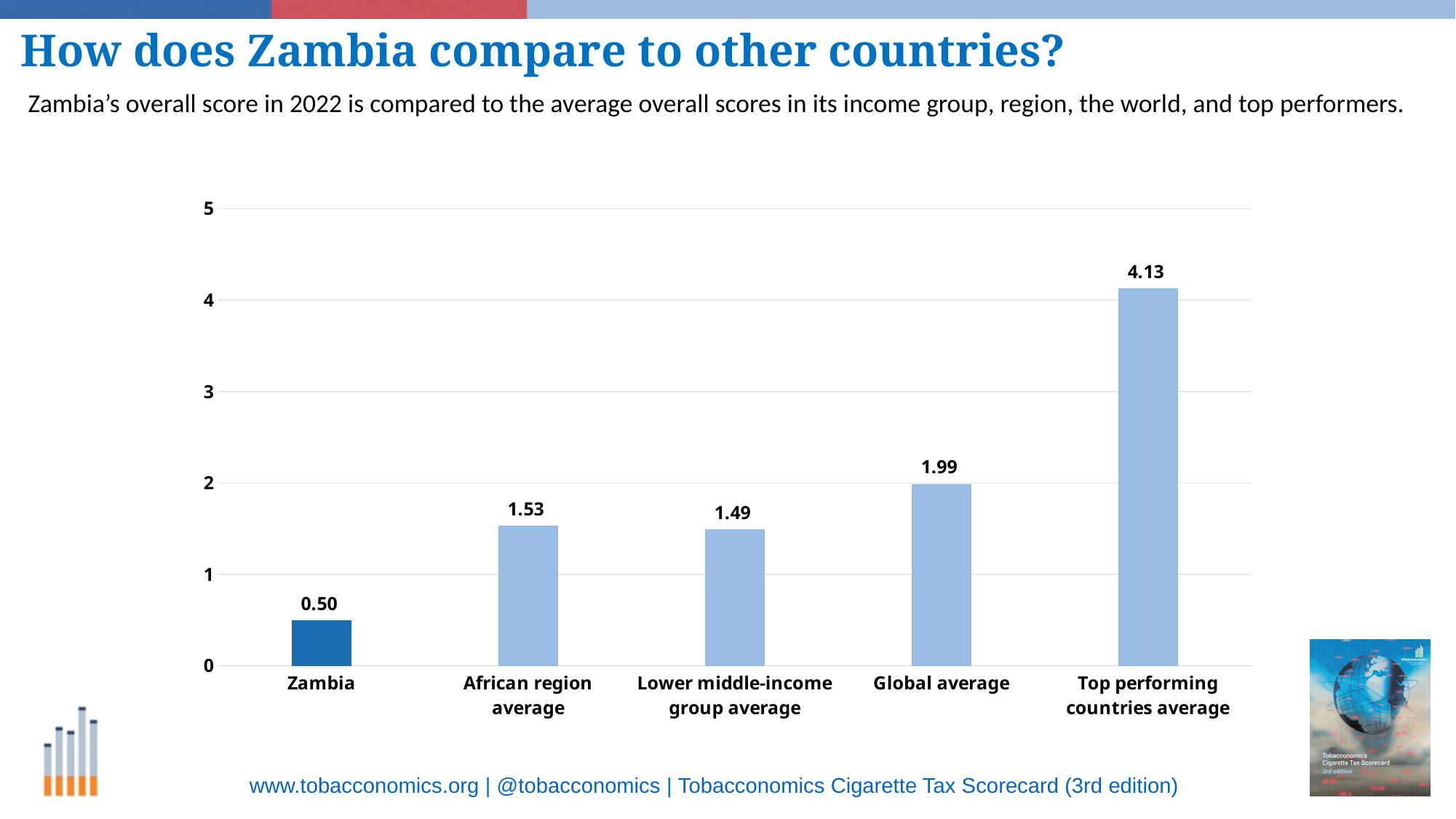
Which bar is shown in a darker blue than the others? Zambia What is the value for the Top performing countries average? 4.13 What is the value for Zambia? 0.50 What is the difference between the Top performing countries average and Zambia? 3.63 What is the difference between the Global average and the African region average? 0.46 What kind of chart is shown on the slide? Bar chart Which category has the lowest value? Zambia What is the value for the Lower middle-income group average? 1.49 Which category has the highest value? Top performing countries average How many categories are shown in the chart? 5 Which is larger, the African region average or the Lower middle-income group average? African region average What is the value for the Global average? 1.99